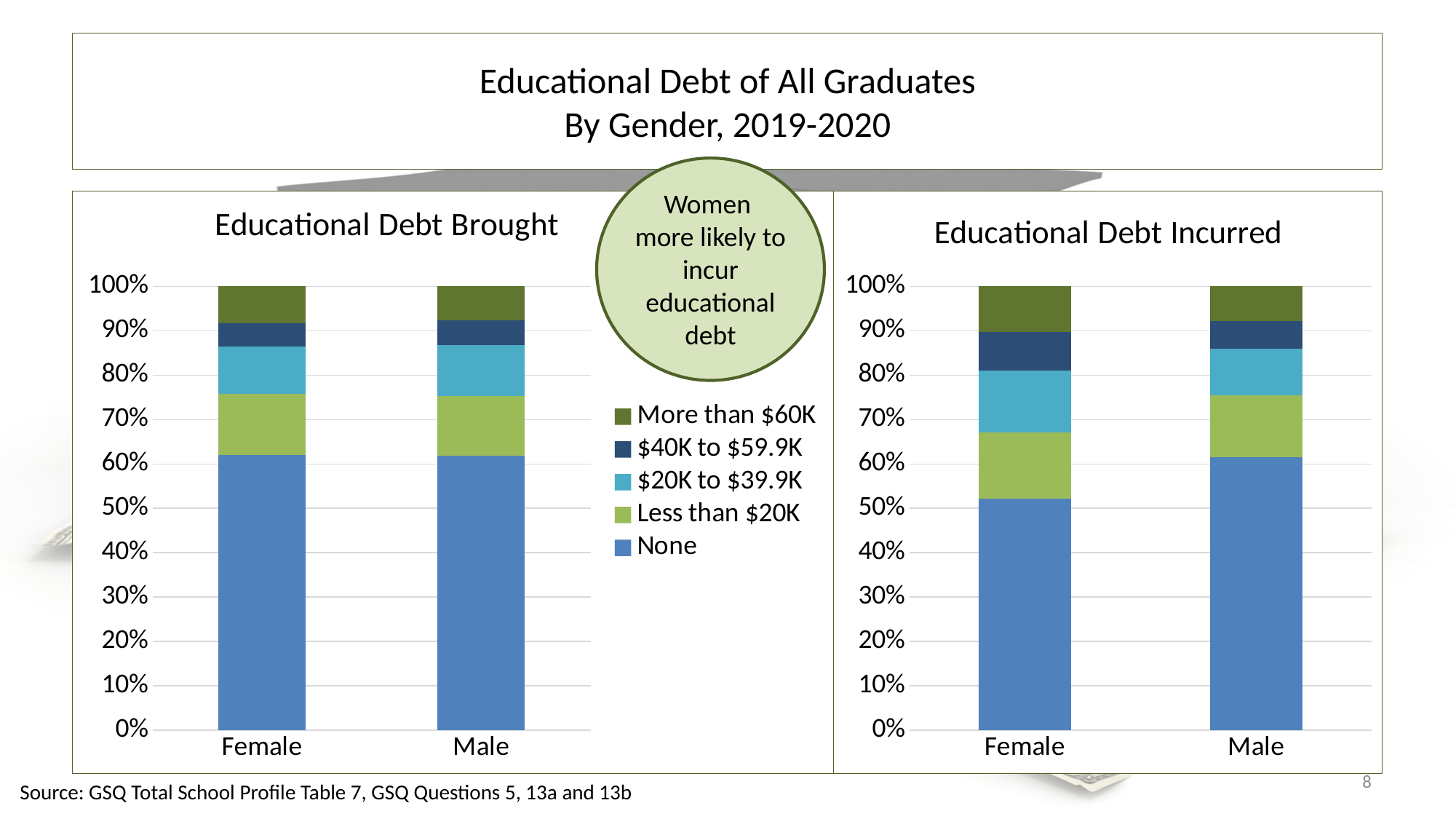
In the "Educational Debt Incurred" chart, is the "None" value for Female greater or less than 60%? less In the "Educational Debt Brought" chart, is the "None" value for Female greater or less than 60%? greater Which legend entry is shown in the lightest blue colour at the bottom of each stacked bar? None What kind of chart is the "Educational Debt Brought" chart? Stacked bar chart In the "Educational Debt Incurred" chart, which category has the larger "None" share, Female or Male? Male What is the title of the chart on the right side of the slide? Educational Debt Incurred In the "Educational Debt Incurred" chart, is the "None" value for Male greater or less than 60%? greater In the "Educational Debt Brought" chart, what is the total of the stacked bar for Female? 100% How many series does the legend list? 5 How many categories are shown on the x axis of the "Educational Debt Incurred" chart? 2